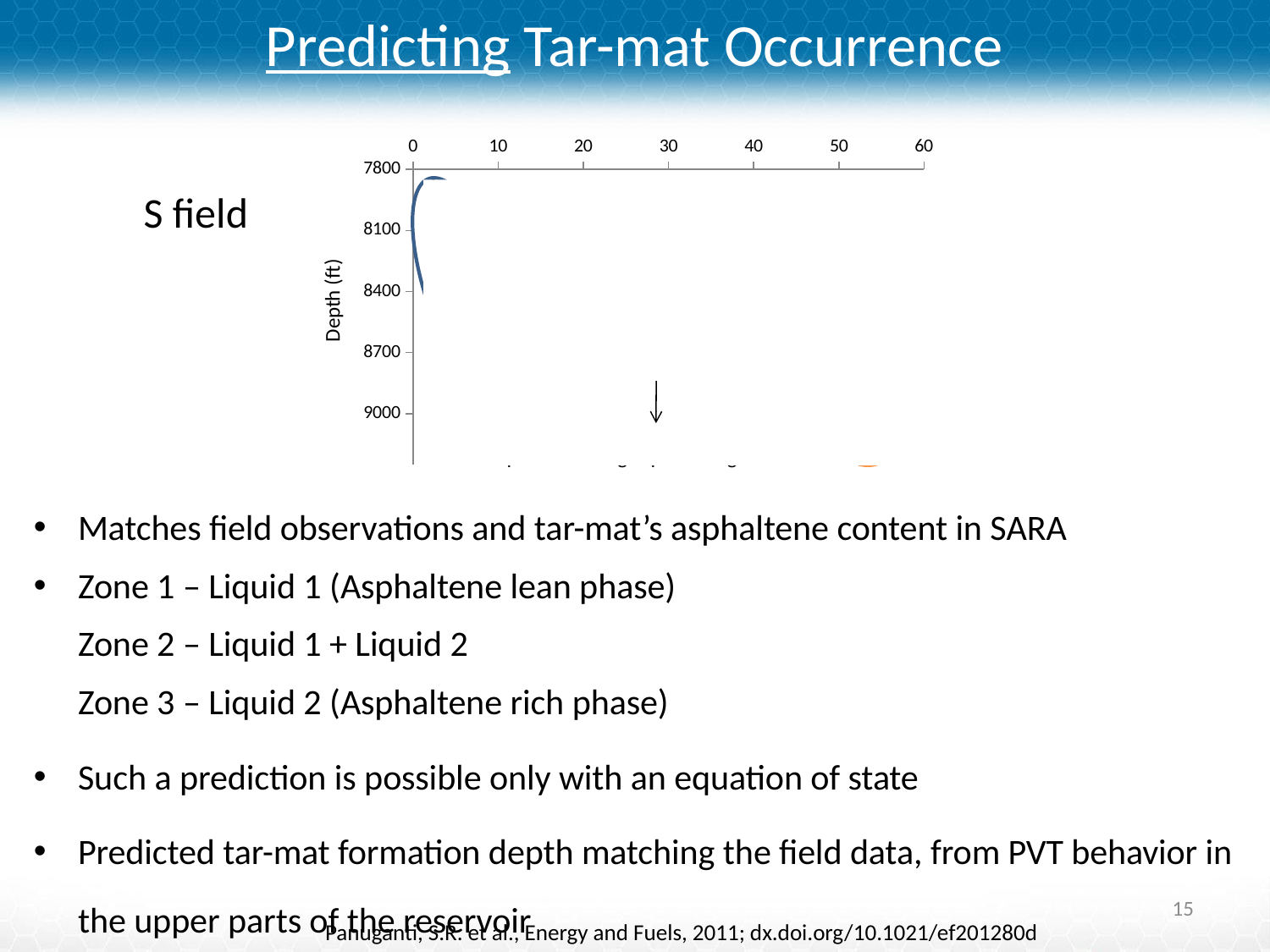
How many tick labels are shown on the vertical (Depth) axis of the chart? 5 Is the plotted curve's horizontal value at a depth of 7800 ft greater or less than 20? less What is the largest value shown on the horizontal axis of the chart? 60 Is the plotted curve's horizontal value at a depth of 8100 ft greater or less than 10? less What is the label of the vertical axis of the chart? Depth (ft) What is the interval between consecutive tick labels on the Depth axis? 300 What is the shallowest depth value labelled on the vertical axis of the chart? 7800 What kind of chart is shown on the slide? line chart How many tick labels are shown on the horizontal axis of the chart? 7 What is the deepest depth value labelled on the vertical axis of the chart? 9000